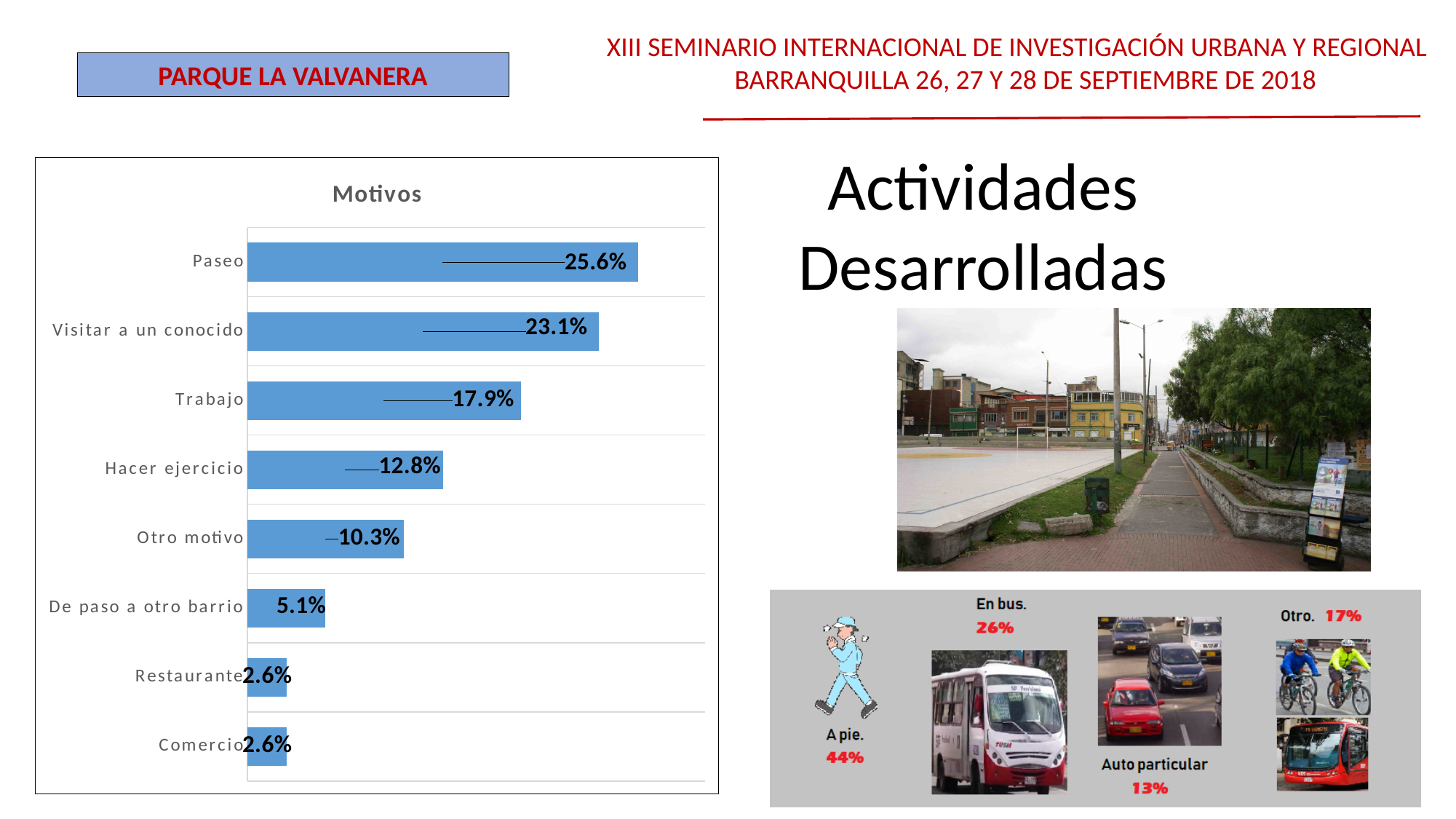
In the Motivos chart, what is the difference between the values for Trabajo and Hacer ejercicio? 5.1% In the Motivos chart, what is the value for De paso a otro barrio? 5.1% In the Motivos chart, which category has the highest value? Paseo What kind of chart is the Motivos chart? Bar chart In the Motivos chart, what is the value for Paseo? 25.6% In the Motivos chart, what is the value for Hacer ejercicio? 12.8% How many categories are shown in the Motivos chart? 8 What is the title of the chart on the left of the slide? Motivos In the Motivos chart, which is larger: Otro motivo or De paso a otro barrio? Otro motivo In the Motivos chart, what is the value for Trabajo? 17.9% In the Motivos chart, what is the value for Restaurante? 2.6% In the Motivos chart, what is the difference between the values for Paseo and Visitar a un conocido? 2.5%